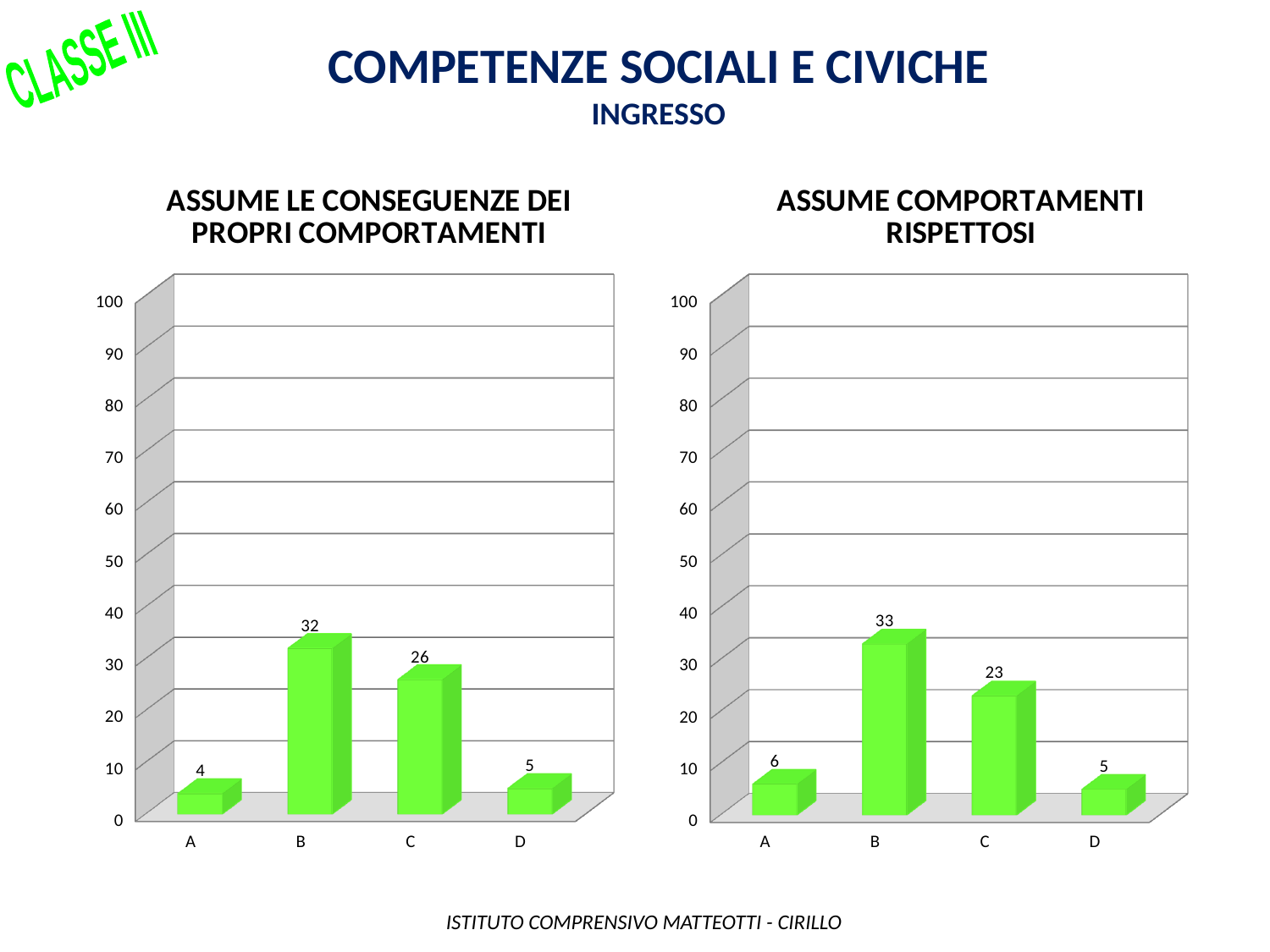
In the chart titled 'ASSUME LE CONSEGUENZE DEI PROPRI COMPORTAMENTI', is the value for C greater or less than 20? greater In the chart titled 'ASSUME LE CONSEGUENZE DEI PROPRI COMPORTAMENTI', what is the value for category A? 4 In the chart titled 'ASSUME LE CONSEGUENZE DEI PROPRI COMPORTAMENTI', what is the value for category B? 32 In the chart titled 'ASSUME LE CONSEGUENZE DEI PROPRI COMPORTAMENTI', what is the difference between the values for B and C? 6 In the chart titled 'ASSUME COMPORTAMENTI RISPETTOSI', what is the difference between the values for B and A? 27 How many categories are shown on the x axis of the chart titled 'ASSUME COMPORTAMENTI RISPETTOSI'? 4 In the chart titled 'ASSUME COMPORTAMENTI RISPETTOSI', which is larger, the value for A or the value for D? A In the chart titled 'ASSUME LE CONSEGUENZE DEI PROPRI COMPORTAMENTI', which category has the highest value? B In the chart titled 'ASSUME COMPORTAMENTI RISPETTOSI', what is the value for category C? 23 What kind of chart is the chart titled 'ASSUME LE CONSEGUENZE DEI PROPRI COMPORTAMENTI'? Bar chart What is the maximum value shown on the vertical axis of the chart titled 'ASSUME COMPORTAMENTI RISPETTOSI'? 100 In the chart titled 'ASSUME COMPORTAMENTI RISPETTOSI', which category has the lowest value? D